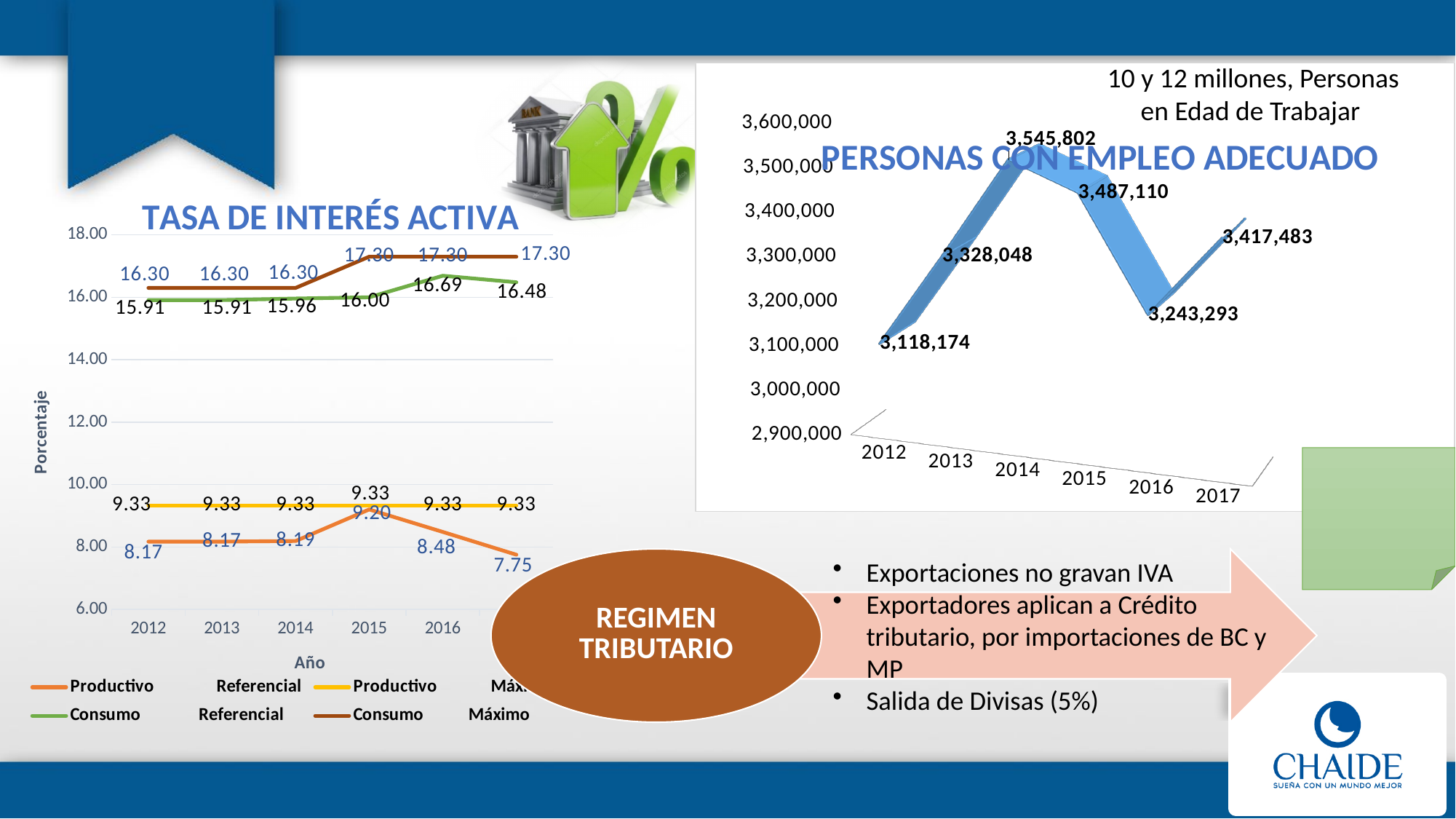
In the PERSONAS CON EMPLEO ADECUADO chart, which year has the lowest value? 2012 In the PERSONAS CON EMPLEO ADECUADO chart, what is the difference between the 2014 value and the 2012 value? 427,628 In the PERSONAS CON EMPLEO ADECUADO chart, which year has the highest value? 2014 In the TASA DE INTERÉS ACTIVA chart, what is the difference between the Consumo Máximo and Consumo Referencial values in 2015? 1.30 In the PERSONAS CON EMPLEO ADECUADO chart, what is the value for 2014? 3,545,802 In the PERSONAS CON EMPLEO ADECUADO chart, is the value for 2016 larger or smaller than the value for 2017? smaller In the TASA DE INTERÉS ACTIVA chart, what is the Consumo Máximo value for 2012? 16.30 What type of chart is the TASA DE INTERÉS ACTIVA chart? Line chart How many series does the legend of the TASA DE INTERÉS ACTIVA chart list? 4 In the TASA DE INTERÉS ACTIVA chart, what is the Consumo Referencial value for 2016? 16.69 How many years are plotted in the PERSONAS CON EMPLEO ADECUADO chart? 6 In the TASA DE INTERÉS ACTIVA chart, what is the Productivo Referencial value for 2015? 9.20